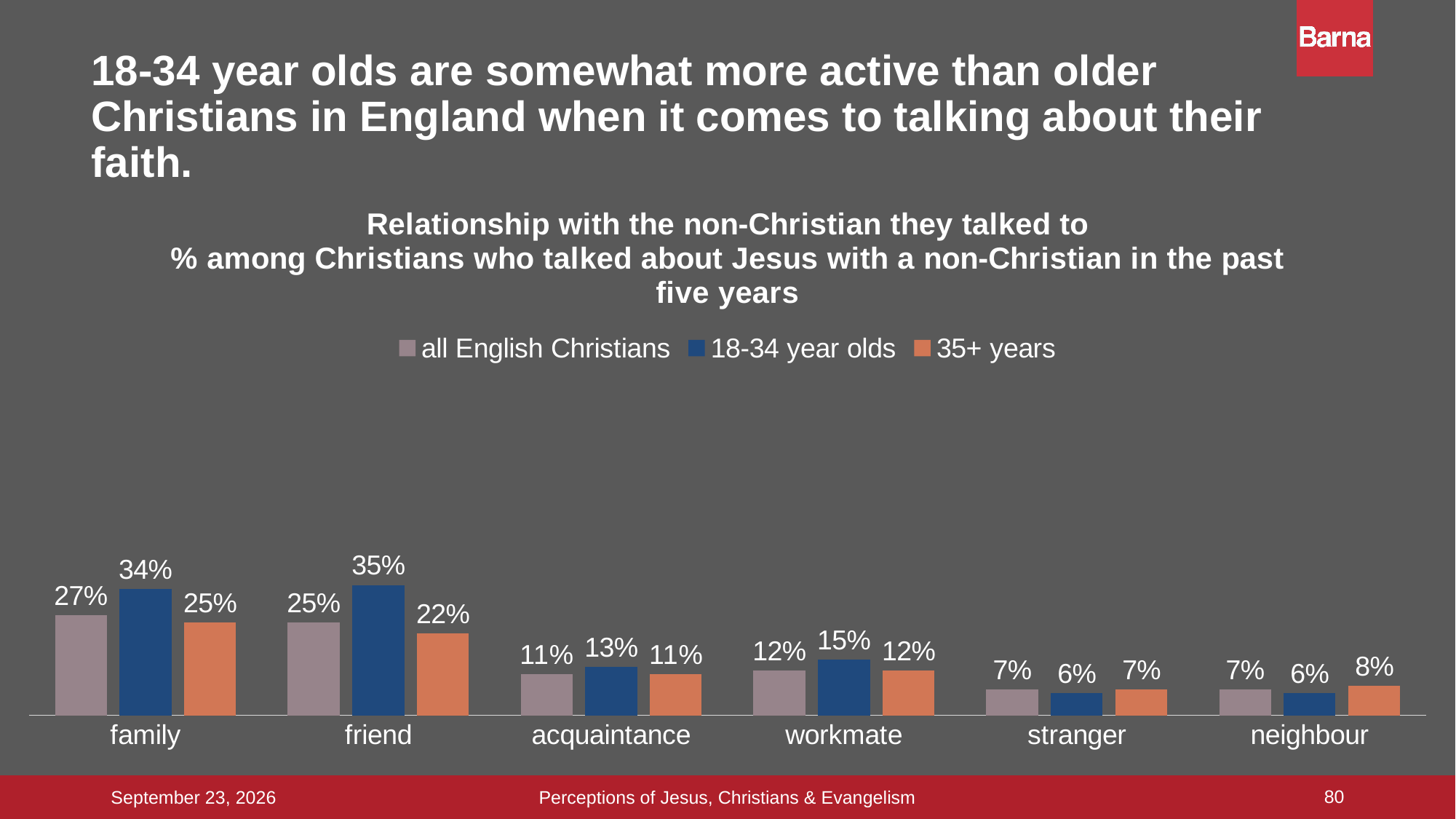
What is the difference between all English Christians and 18-34 year olds in the acquaintance category? 2% Which category has the highest value for 18-34 year olds? friend What kind of chart is shown on the slide? bar chart What is the value for 18-34 year olds in the family category? 34% How many series does the legend list? 3 How many relationship categories are shown on the x axis? 6 What is the value for 35+ years in the friend category? 22% Which category has the lowest value for all English Christians? stranger and neighbour (both 7%) What is the difference between 18-34 year olds and 35+ years in the friend category? 13% Which colour represents the 18-34 year olds series in the legend? blue Which is larger in the neighbour category: 18-34 year olds or 35+ years? 35+ years What is the value for all English Christians in the workmate category? 12%